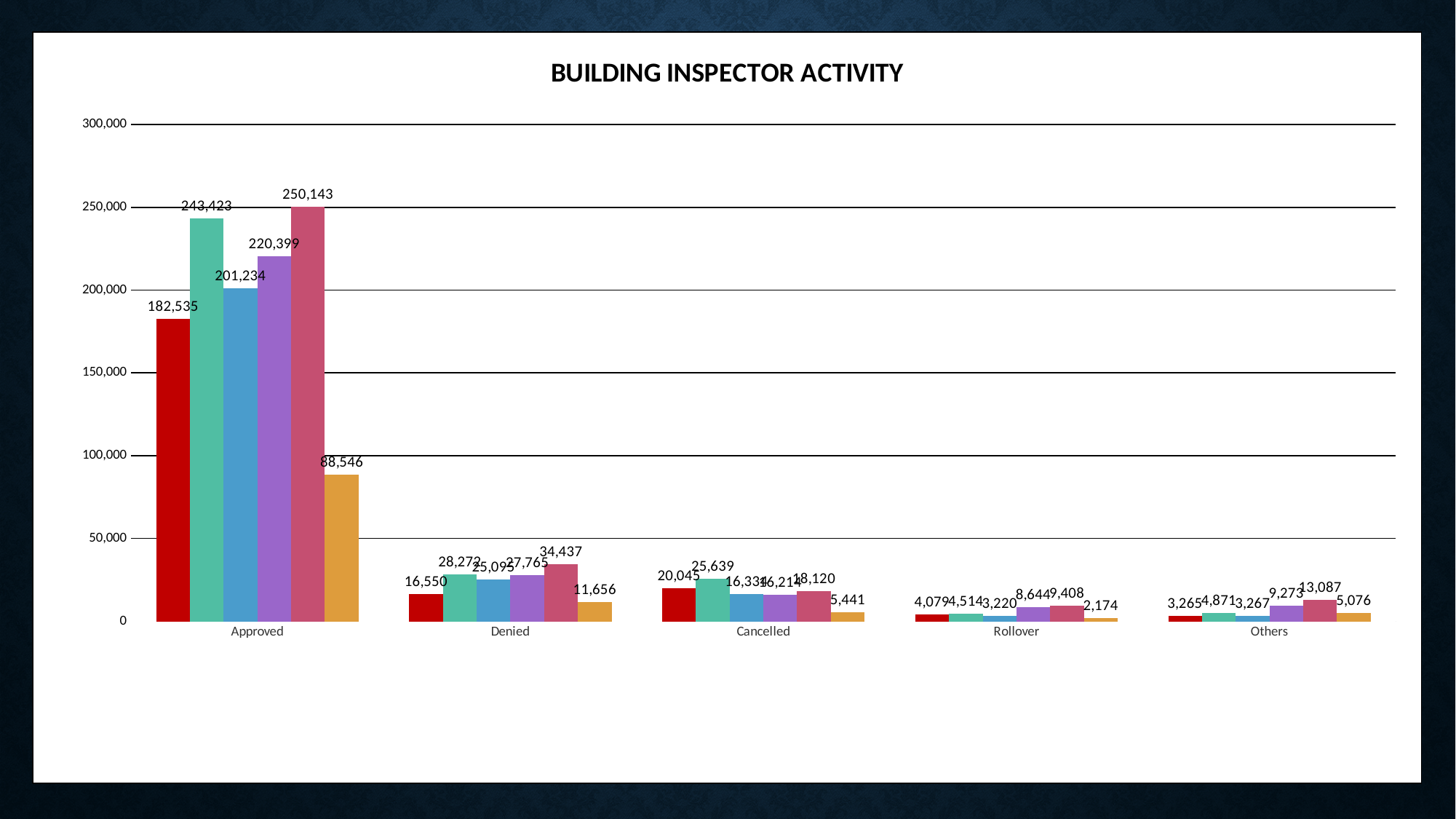
Is the value of the teal bar in the Approved category greater or less than 200,000? greater What is the value of the pink bar in the Denied category? 34,437 What is the difference between the pink bar and the red bar in the Approved category? 67,608 Which category has the highest values overall? Approved What is the title of the chart? BUILDING INSPECTOR ACTIVITY How many bars are plotted for each category? 6 What is the value of the orange bar in the Rollover category? 2,174 What kind of chart is shown on the slide? bar chart How many categories are shown on the x axis? 5 What is the value of the orange bar in the Approved category? 88,546 What is the value of the tallest bar in the Approved category? 250,143 What is the value of the red bar in the Approved category? 182,535